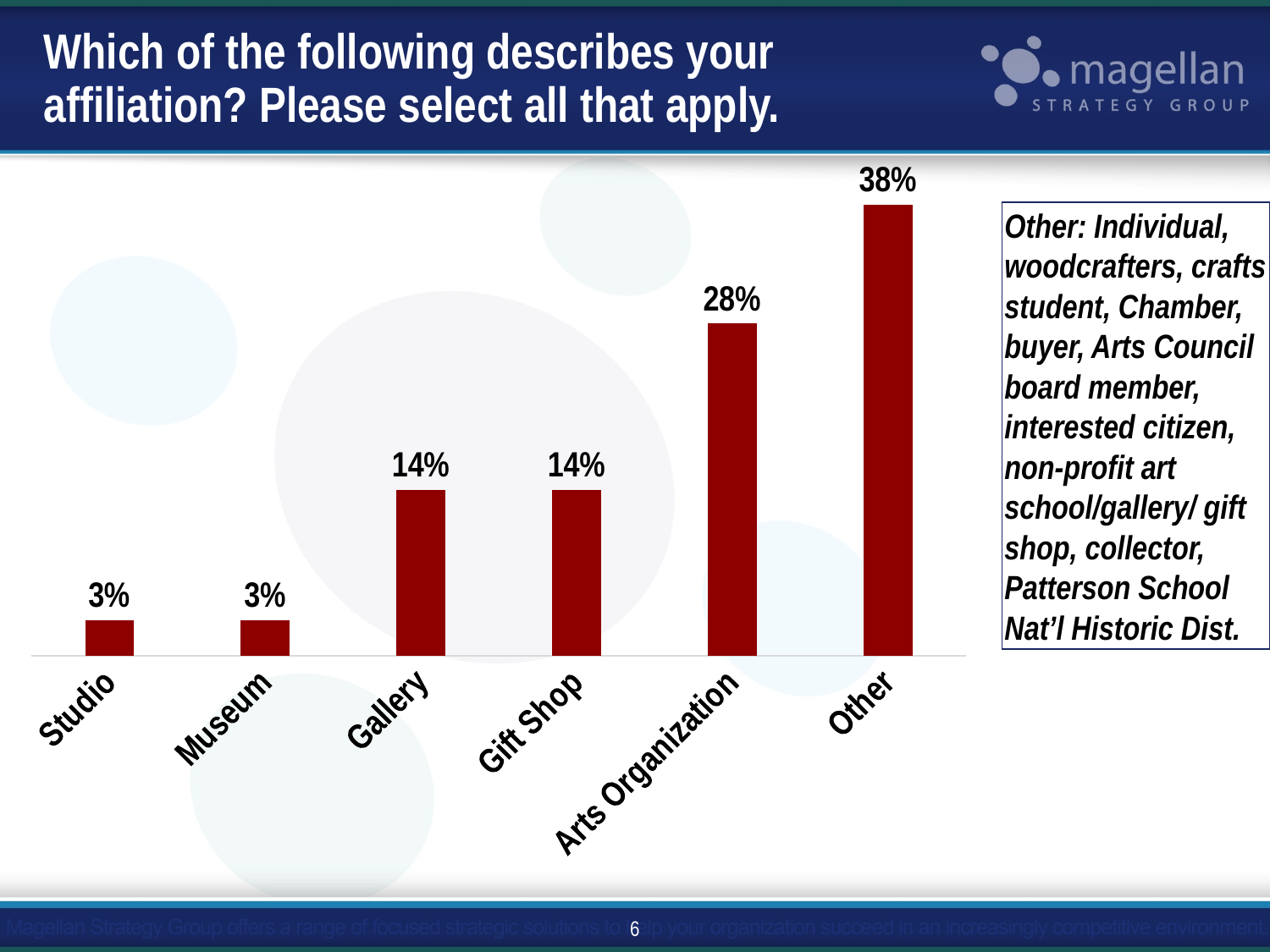
Do the values generally rise or fall moving from Studio to Other along the x axis? Rise What percentage of respondents selected Arts Organization as their affiliation? 28% What is the value shown for Gallery? 14% Which affiliation category has the highest value? Other How many affiliation categories are shown on the x axis? 6 What colour are the bars in the chart? Dark red What kind of chart is shown on the slide? Bar chart Which two categories share the same value of 14%? Gallery and Gift Shop Which is larger, the value for Arts Organization or the value for Gift Shop? Arts Organization What is the value shown for Studio? 3% What is the difference between the Gift Shop value and the Museum value? 11% What is the difference between the Other bar and the Arts Organization bar? 10%